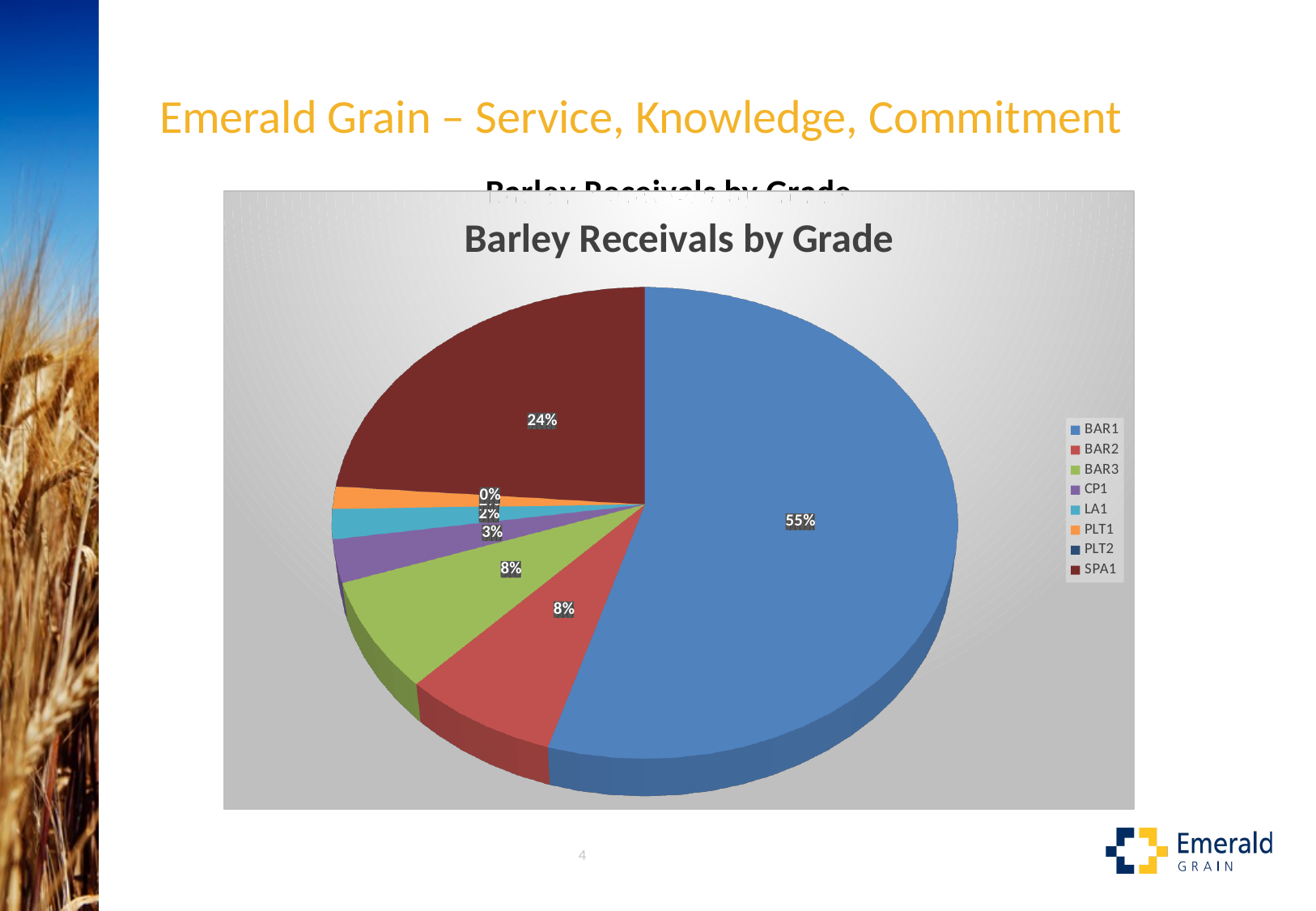
What percentage is shown for BAR2? 8% Which grade has the largest share of barley receivals? BAR1 Which is larger, the share for SPA1 or the share for BAR3? SPA1 How many grades are listed in the legend? 8 What share of barley receivals is BAR1? 55% What is the difference in percentage points between BAR1 and SPA1? 31 percentage points What is the title of the chart? Barley Receivals by Grade What colour is the BAR1 slice? Blue What percentage is shown for CP1? 3% What type of chart is shown on the slide? Pie chart What share of barley receivals is SPA1? 24% What percentage is shown for LA1? 2%